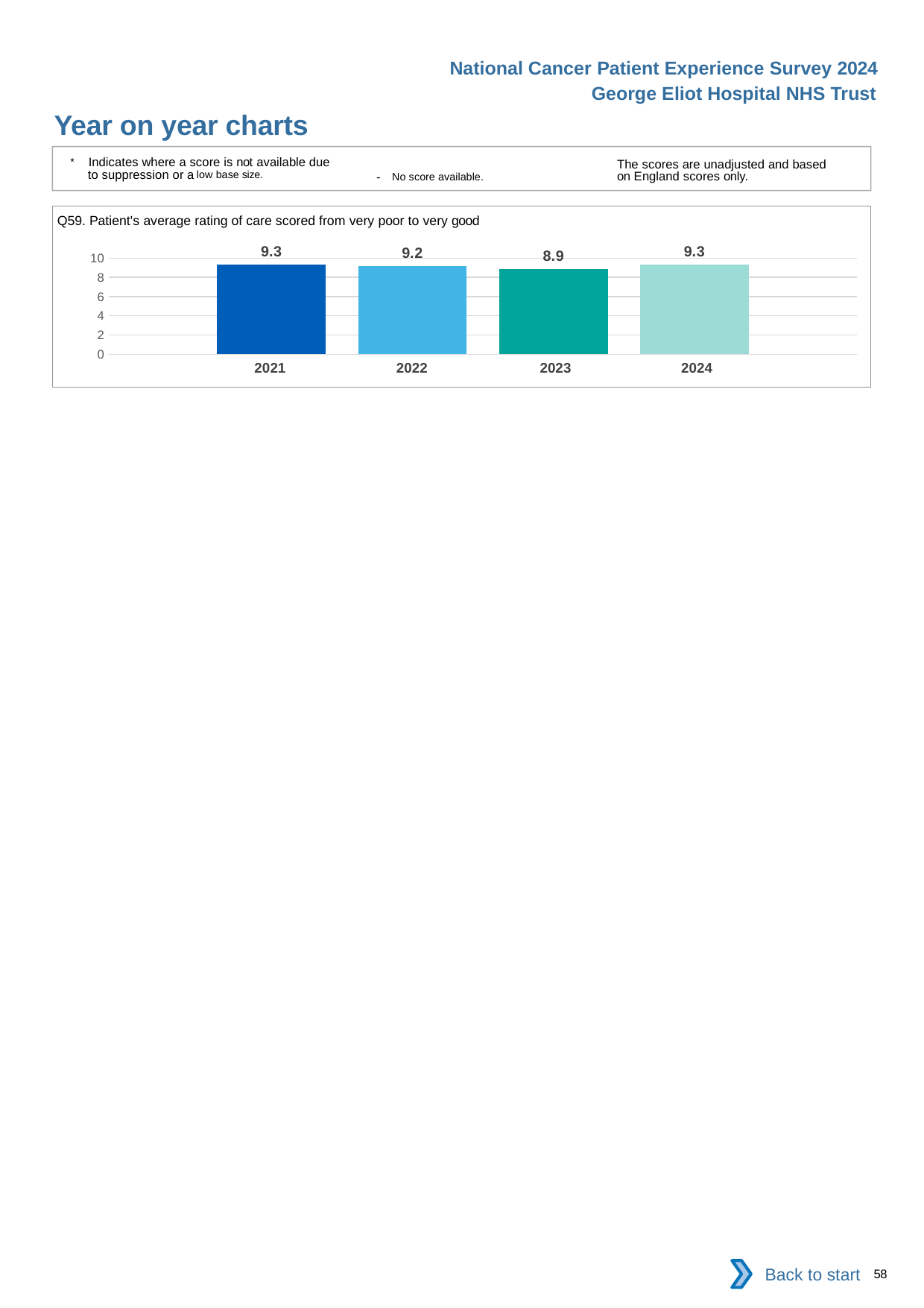
What is the difference between the values for 2024 and 2022? 0.1 Is the value for 2023 greater or less than 8? greater What kind of chart is shown? bar chart What is the difference between the values for 2021 and 2023? 0.4 Which is larger, the value for 2022 or the value for 2023? 2022 What is the value for 2024? 9.3 What is the title of the chart? Q59. Patient's average rating of care scored from very poor to very good How many years are shown on the chart? 4 Which year has the lowest value? 2023 What is the value for 2021? 9.3 What is the value for 2023? 8.9 What is the value for 2022? 9.2